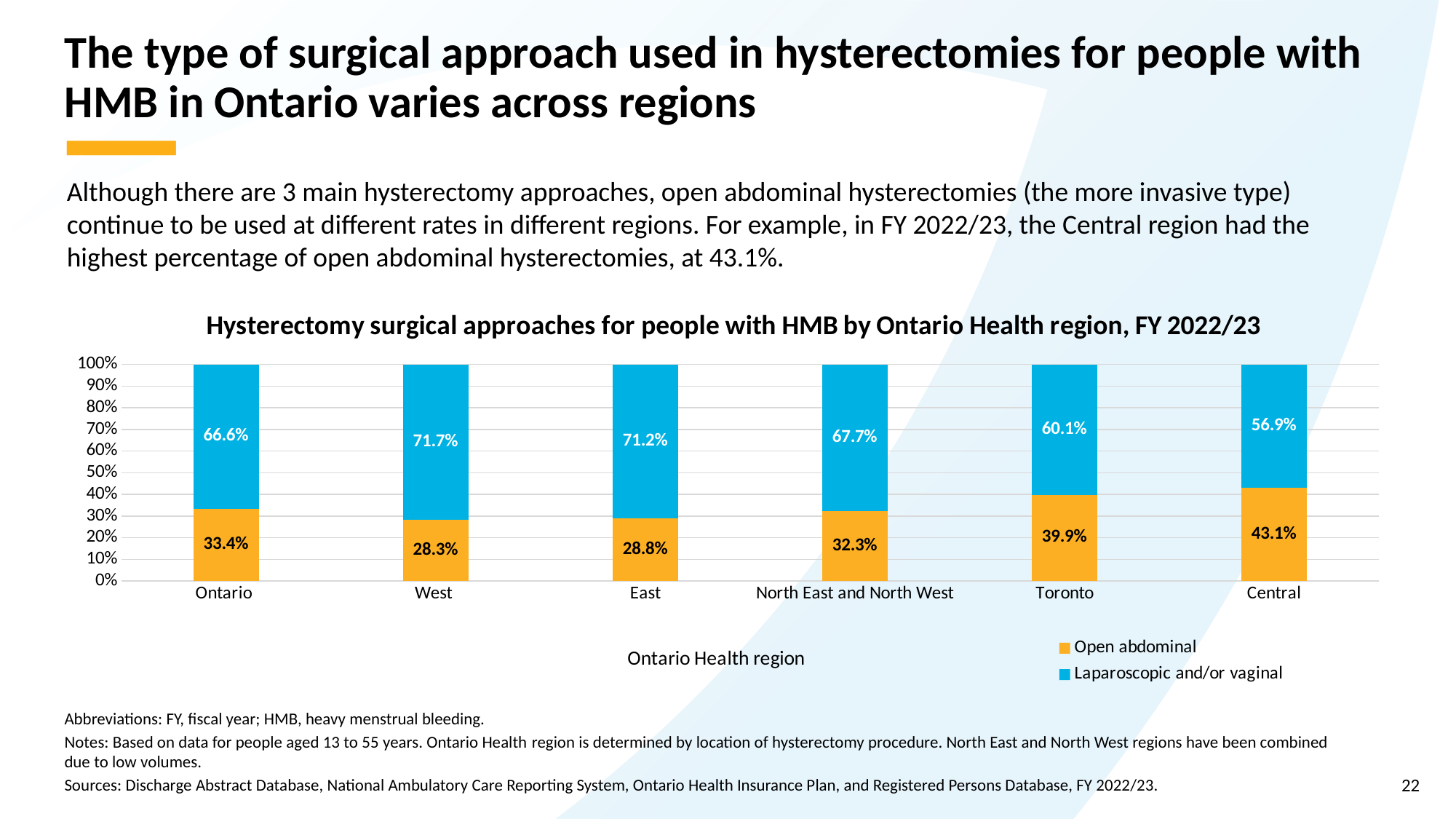
How many regions are shown on the x axis? 6 What is the total of the stacked bar for the North East and North West region? 100% What is the Open abdominal percentage for Toronto? 39.9% Which region has the highest Open abdominal percentage? Central How many series does the legend list? 2 What is the Laparoscopic and/or vaginal percentage for the West region? 71.7% What is the difference in Open abdominal percentage between Central and West? 14.8% Which region has the lowest Open abdominal percentage? West Which has a larger Open abdominal percentage, Toronto or East? Toronto What kind of chart is shown? Stacked bar chart What percentage of hysterectomies in the Central region were open abdominal? 43.1% Which region has the highest Laparoscopic and/or vaginal percentage? West